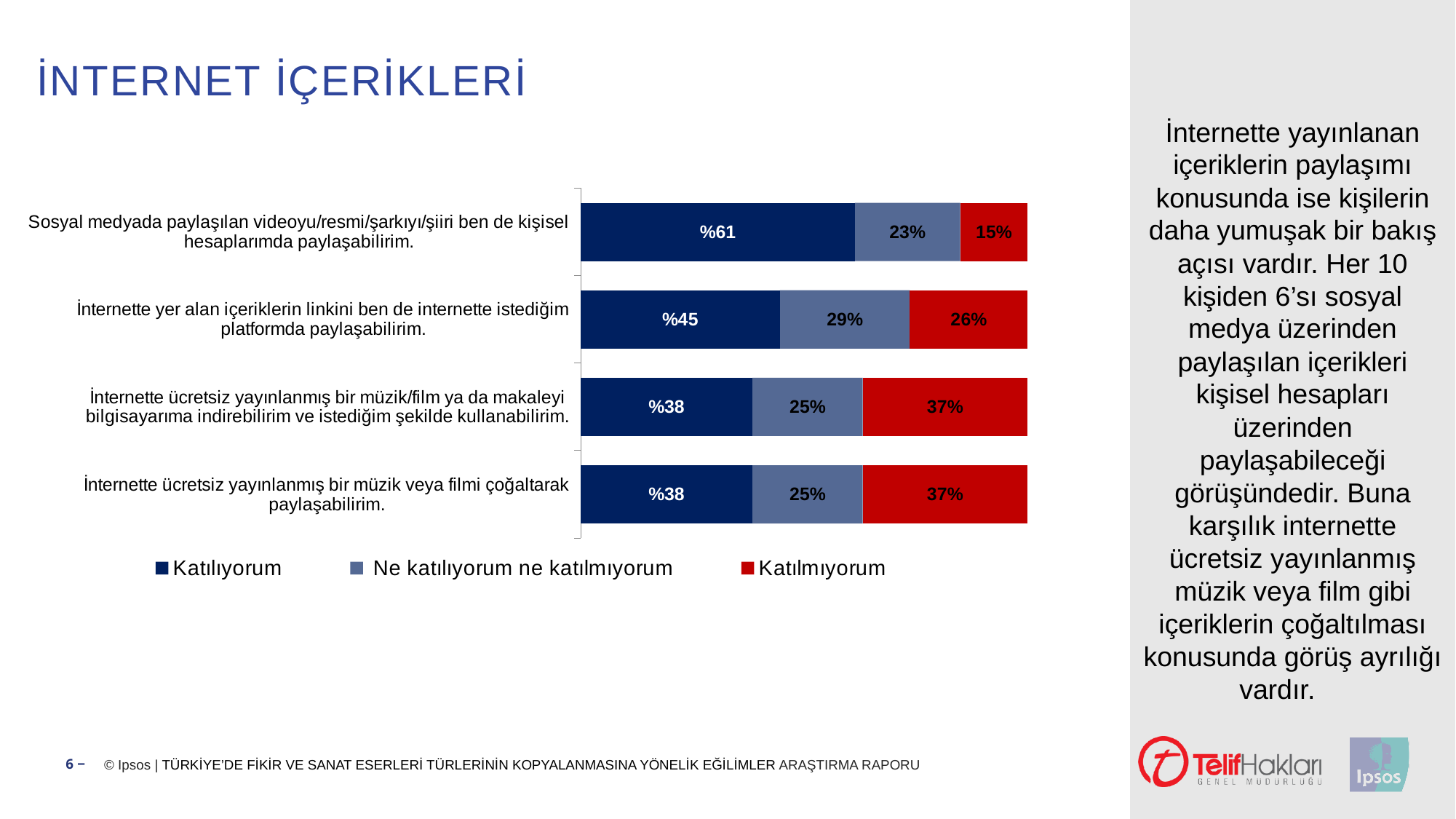
Which statement has the highest 'Katılıyorum' value? Sosyal medyada paylaşılan videoyu/resmi/şarkıyı/şiiri ben de kişisel hesaplarımda paylaşabilirim. Which is larger for 'İnternette ücretsiz yayınlanmış bir müzik/film ya da makaleyi bilgisayarıma indirebilirim ve istediğim şekilde kullanabilirim.': the 'Katılıyorum' value or the 'Katılmıyorum' value? Katılıyorum What is the difference between the 'Katılıyorum' values for the first statement (%61) and the second statement (%45)? %16 What is the 'Katılmıyorum' value for 'İnternette yer alan içeriklerin linkini ben de internette istediğim platformda paylaşabilirim.'? 26% Which statement has the lowest 'Katılmıyorum' value? Sosyal medyada paylaşılan videoyu/resmi/şarkıyı/şiiri ben de kişisel hesaplarımda paylaşabilirim. Which colour represents the 'Katılmıyorum' series in the chart? Red What is the total of the three segments for 'İnternette yer alan içeriklerin linkini ben de internette istediğim platformda paylaşabilirim.'? 100% What is the 'Ne katılıyorum ne katılmıyorum' value for 'İnternette ücretsiz yayınlanmış bir müzik veya filmi çoğaltarak paylaşabilirim.'? 25% What is the 'Katılıyorum' value for 'Sosyal medyada paylaşılan videoyu/resmi/şarkıyı/şiiri ben de kişisel hesaplarımda paylaşabilirim.'? %61 How many statements (categories) are plotted in the chart? 4 What kind of chart is shown on the slide? Stacked bar chart How many series does the legend list? 3